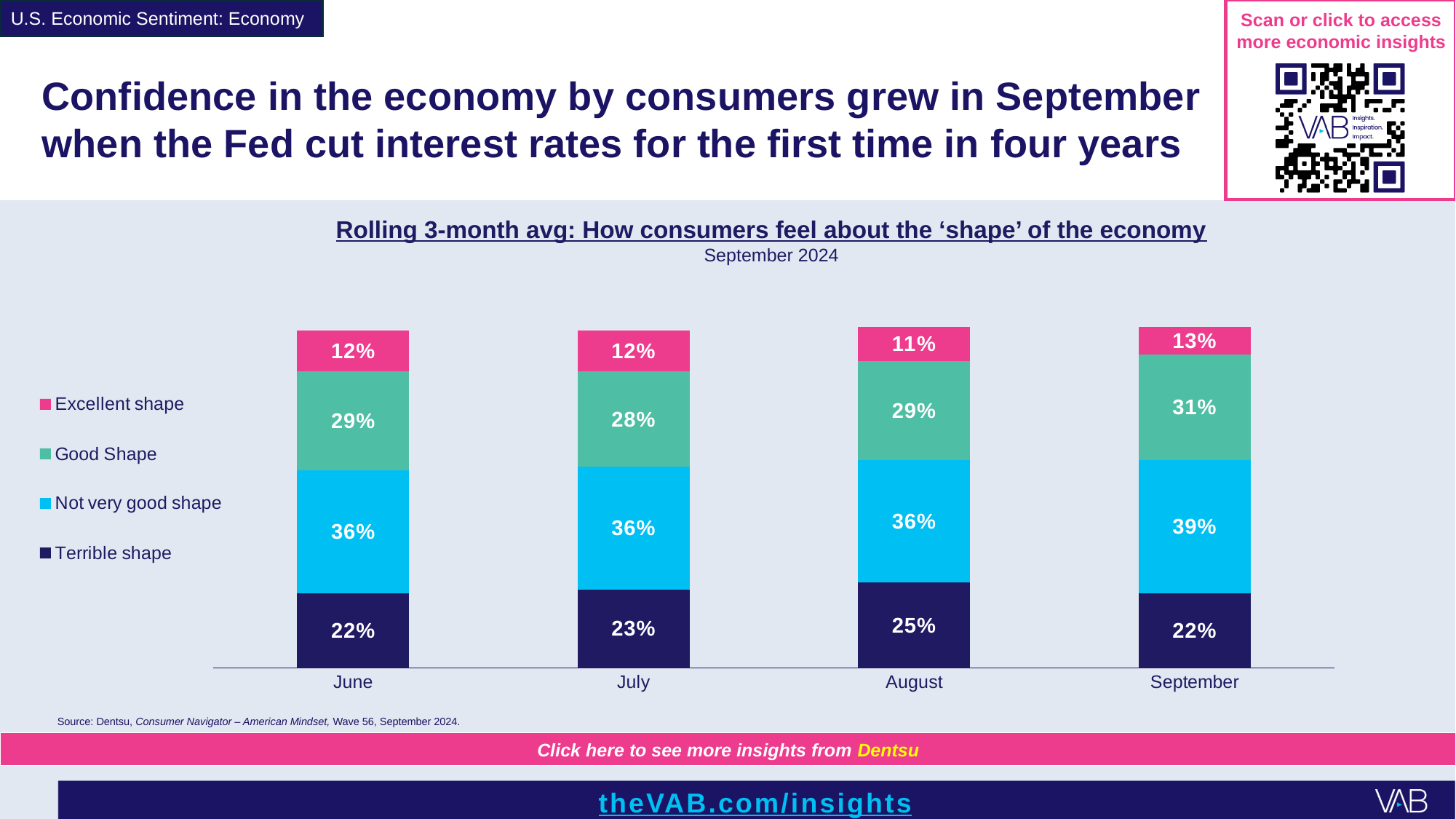
How many series does the legend list? 4 Which month has the larger Terrible shape value, June or August? August What percentage of consumers said the economy was in Good Shape in September? 31% How many months are shown on the x axis of the chart? 4 What is the value for Terrible shape in August? 25% In which month is the Not very good shape share the highest? September What is the value for Excellent shape in July? 12% Does the Good Shape value rise or fall from July to September? Rise By how many percentage points does Good Shape in September exceed Good Shape in July? 3 percentage points What is the value for Not very good shape in June? 36% In which month is the Excellent shape share the lowest? August What kind of chart is shown on the slide? Stacked bar chart